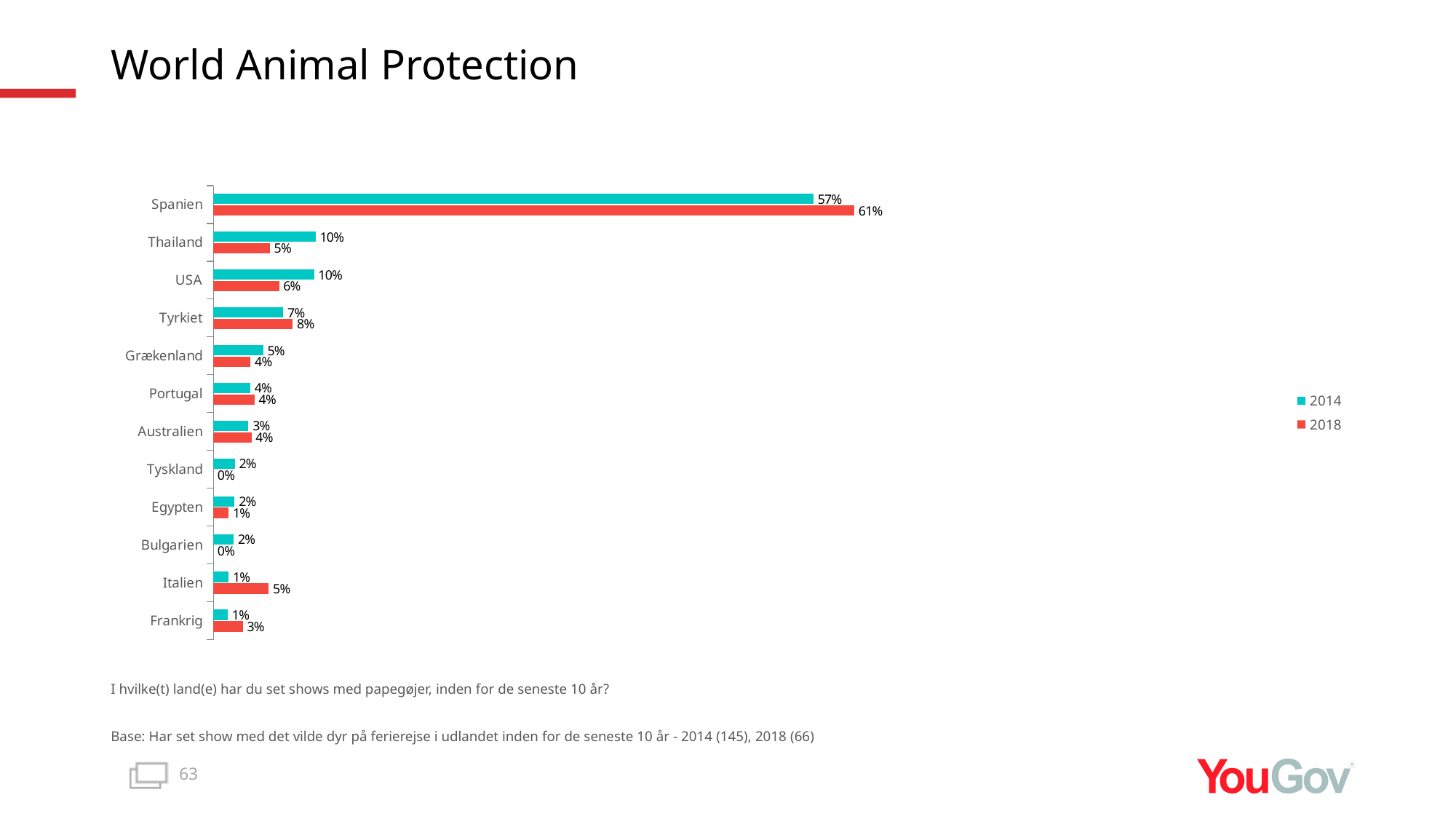
What kind of chart is shown on the slide? Bar chart What is the 2018 value for Spanien? 61% What is the difference between the 2014 and 2018 values for Thailand? 5% Which country has the highest 2014 value? Spanien Which colour represents the 2018 series in the legend? Red What is the 2018 value for Italien? 5% What is the 2018 value for Tyskland? 0% How many series does the legend list? 2 What is the 2014 value for Thailand? 10% How many countries are shown on the chart? 12 Which is larger for USA, the 2014 value or the 2018 value? 2014 What is the difference between the 2018 and 2014 values for Spanien? 4%